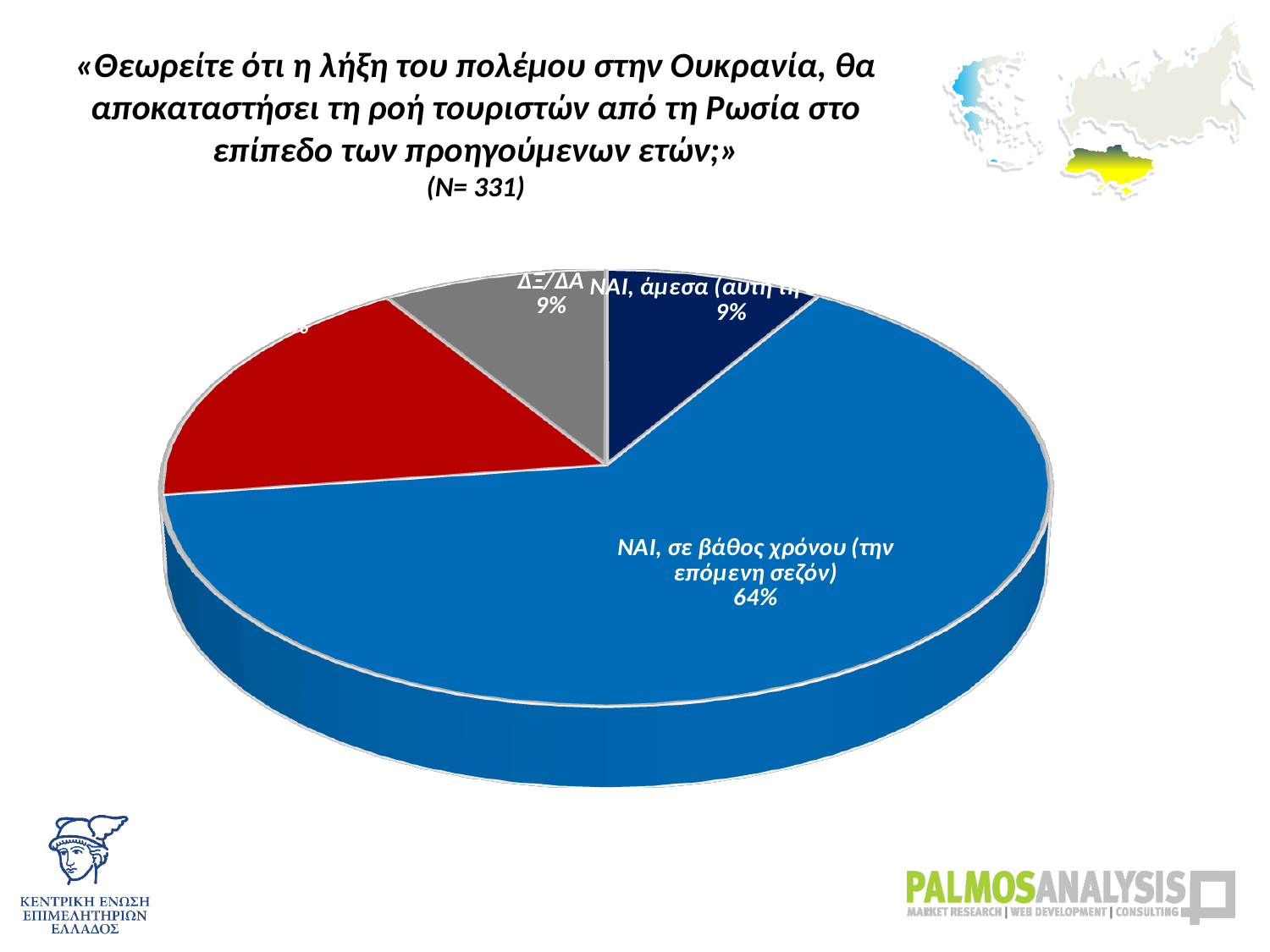
Which response has the largest share of the pie? ΝΑΙ, σε βάθος χρόνου (την επόμενη σεζόν) How many slices does the pie chart have? 4 What colour is the largest slice of the pie chart? blue What percentage of respondents answered "ΔΞ/ΔΑ"? 9% What percentage of respondents answered "ΝΑΙ, σε βάθος χρόνου (την επόμενη σεζόν)"? 64% What kind of chart is shown on the slide? pie chart What percentage is shown for the "ΝΑΙ, άμεσα" slice? 9% Which is larger, the share for "ΝΑΙ, σε βάθος χρόνου (την επόμενη σεζόν)" or the share for "ΔΞ/ΔΑ"? ΝΑΙ, σε βάθος χρόνου (την επόμενη σεζόν) What share of the pie does the "ΝΑΙ, σε βάθος χρόνου (την επόμενη σεζόν)" slice represent? 64% What is the sample size (N) stated under the chart's question? 331 What is the difference in percentage points between the "ΝΑΙ, σε βάθος χρόνου (την επόμενη σεζόν)" share and the "ΔΞ/ΔΑ" share? 55 percentage points